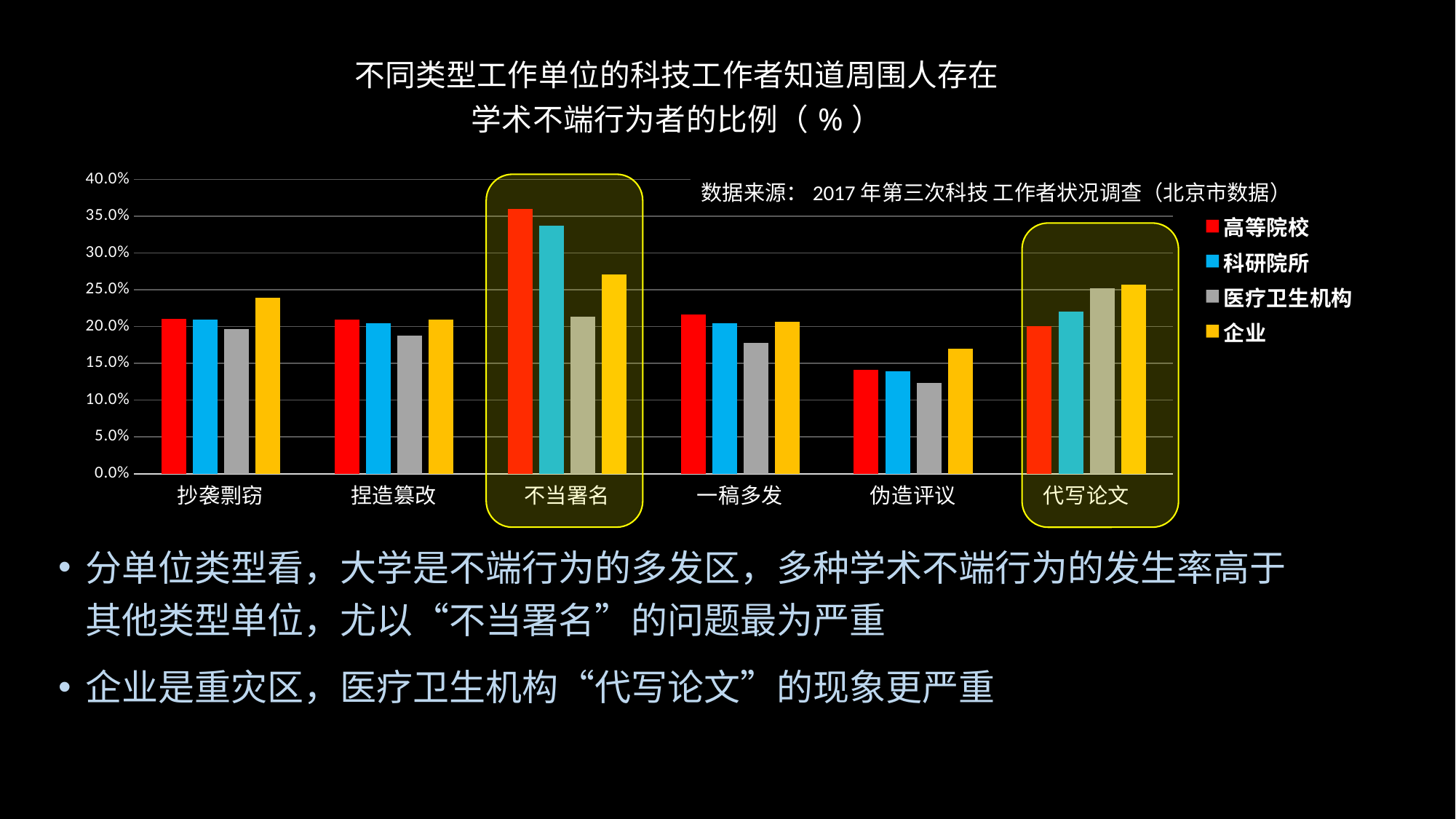
Is the value for 医疗卫生机构 in the 伪造评议 category greater or less than 15.0%? less How many categories of academic misconduct are shown on the x axis? 6 What kind of chart is shown on the slide? bar chart For the 医疗卫生机构 series, which category has the lowest value? 伪造评议 In the 代写论文 category, which is larger: the value for 企业 or for 高等院校? 企业 For the 企业 series, which category has the lowest value? 伪造评议 For the 高等院校 series, which category has the highest value? 不当署名 Is the value for 高等院校 in the 不当署名 category greater or less than 30.0%? greater In the 不当署名 category, which is larger: the value for 高等院校 or for 医疗卫生机构? 高等院校 How many series does the legend list? 4 Is the value for 企业 in the 抄袭剽窃 category greater or less than 20.0%? greater Which two categories are highlighted with yellow boxes on the chart? 不当署名 and 代写论文